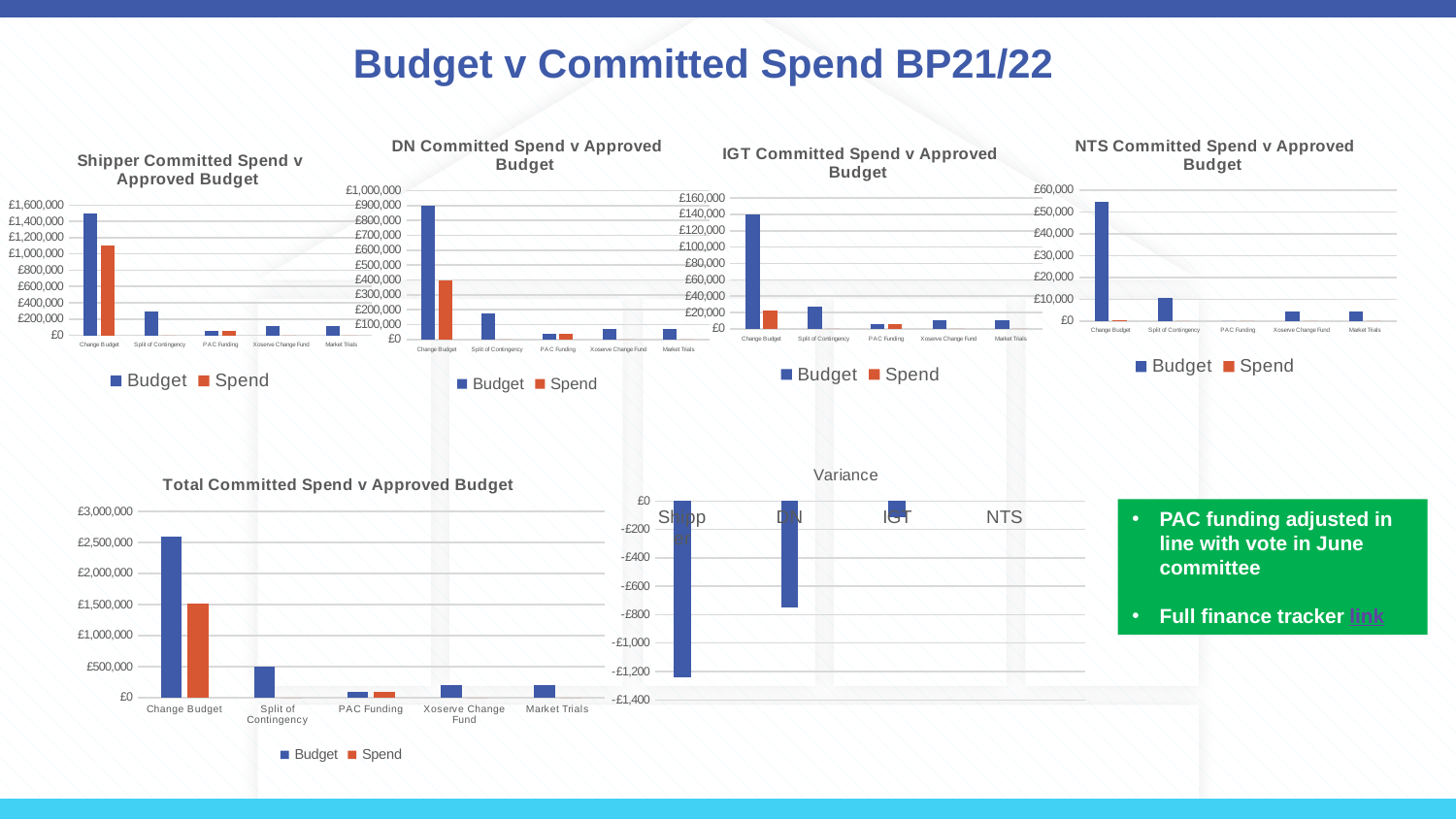
In the 'IGT Committed Spend v Approved Budget' chart, is the Budget value for Change Budget greater or less than £120,000? greater In the 'Variance' chart, is the value for DN greater or less than -£600? less What kind of chart is the 'Shipper Committed Spend v Approved Budget' chart? bar chart In the 'DN Committed Spend v Approved Budget' chart, is the Budget value for Change Budget greater or less than £800,000? greater How many series does the legend of the 'Total Committed Spend v Approved Budget' chart list? 2 In the 'Shipper Committed Spend v Approved Budget' chart, for Change Budget, which is larger: Budget or Spend? Budget How many categories are shown on the x axis of the 'Total Committed Spend v Approved Budget' chart? 5 In the 'Total Committed Spend v Approved Budget' chart, which category has the highest Budget value? Change Budget In the 'Variance' chart, which category has the lowest (most negative) value? Shipper